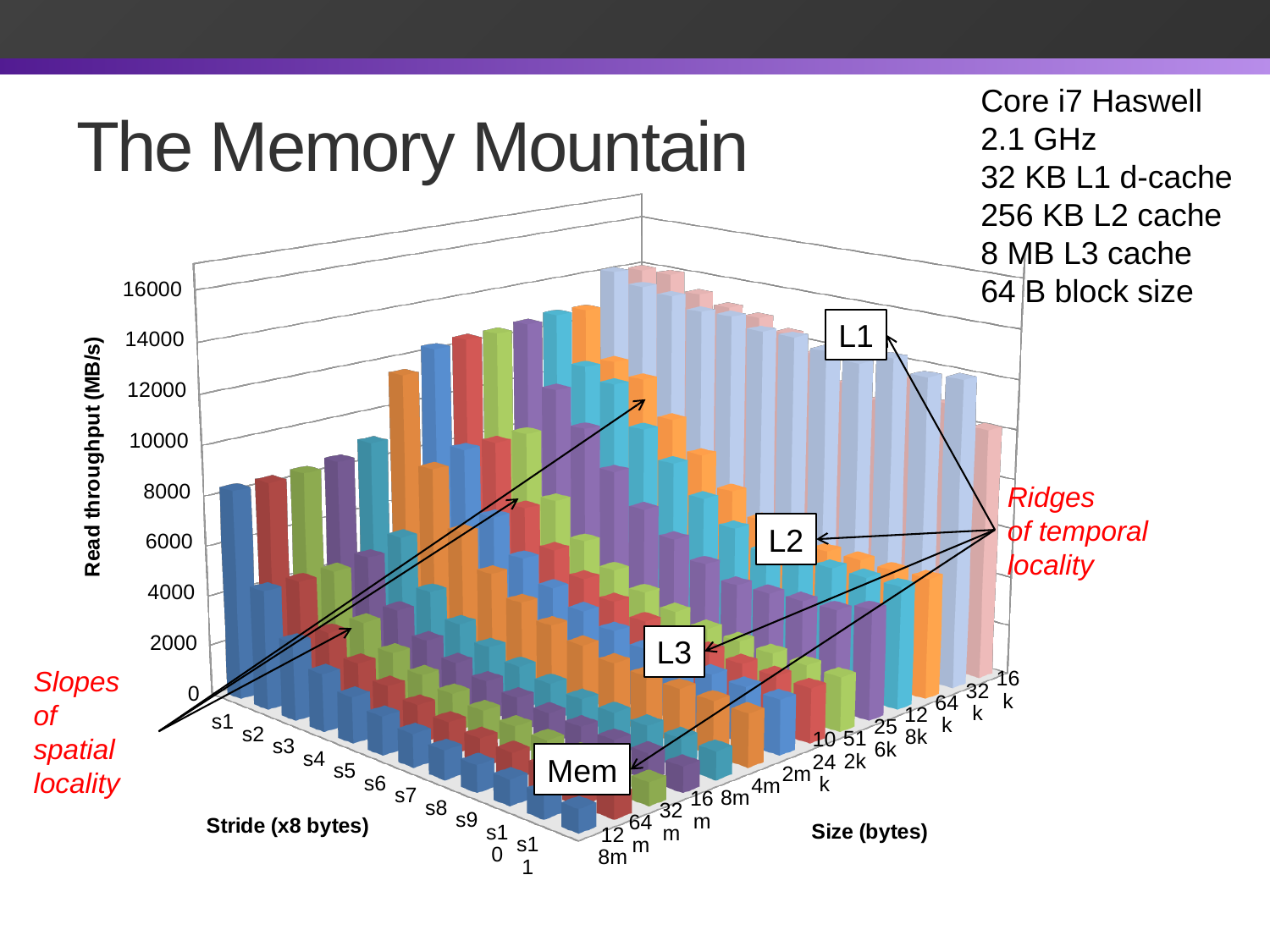
For the 128m size, which has the larger read throughput: stride s1 or stride s11? s1 What are the two horizontal axis titles of the chart? Stride (x8 bytes) and Size (bytes) How many stride categories (s1 through s11) are shown on the stride axis? 11 What is the highest tick value shown on the read throughput axis? 16000 For the 128m size, which stride has the highest read throughput? s1 For the 128m size, is the read throughput at stride s11 greater or less than 4000? less For the 128m size, which stride has the lowest read throughput? s11 What is the label of the vertical axis of the chart? Read throughput (MB/s) For the 128m size, is the read throughput at stride s1 greater or less than 4000? greater For stride s1, does read throughput rise or fall as the size decreases from 128m toward 16k? rise For the 128m size, does read throughput rise or fall as the stride increases from s1 to s11? fall What kind of chart is shown on the slide? 3D bar chart